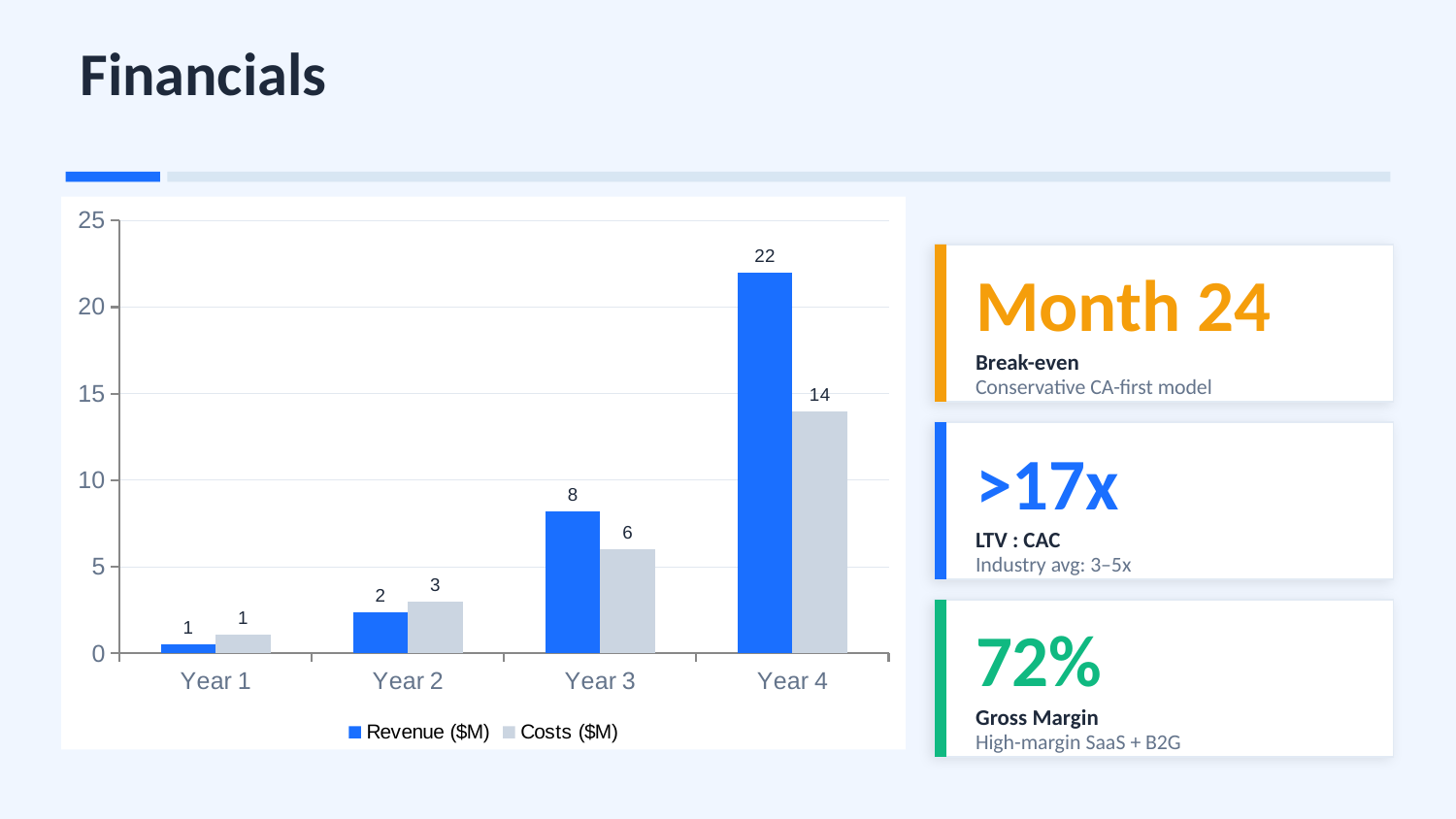
What kind of chart is shown on the slide? Bar chart What is the difference in Revenue ($M) between Year 3 and Year 2? 6 Which year has the lowest Costs ($M)? Year 1 What is the Costs ($M) value for Year 2? 3 What is the difference between Revenue ($M) and Costs ($M) in Year 4? 8 In Year 3, which is larger, Revenue ($M) or Costs ($M)? Revenue ($M) What is the Costs ($M) value for Year 3? 6 What is the Revenue ($M) value for Year 4? 22 How many years are shown on the x axis? 4 Which year has the highest Revenue ($M)? Year 4 Is the Revenue ($M) value for Year 4 greater or less than 20? greater How many series does the legend list? 2